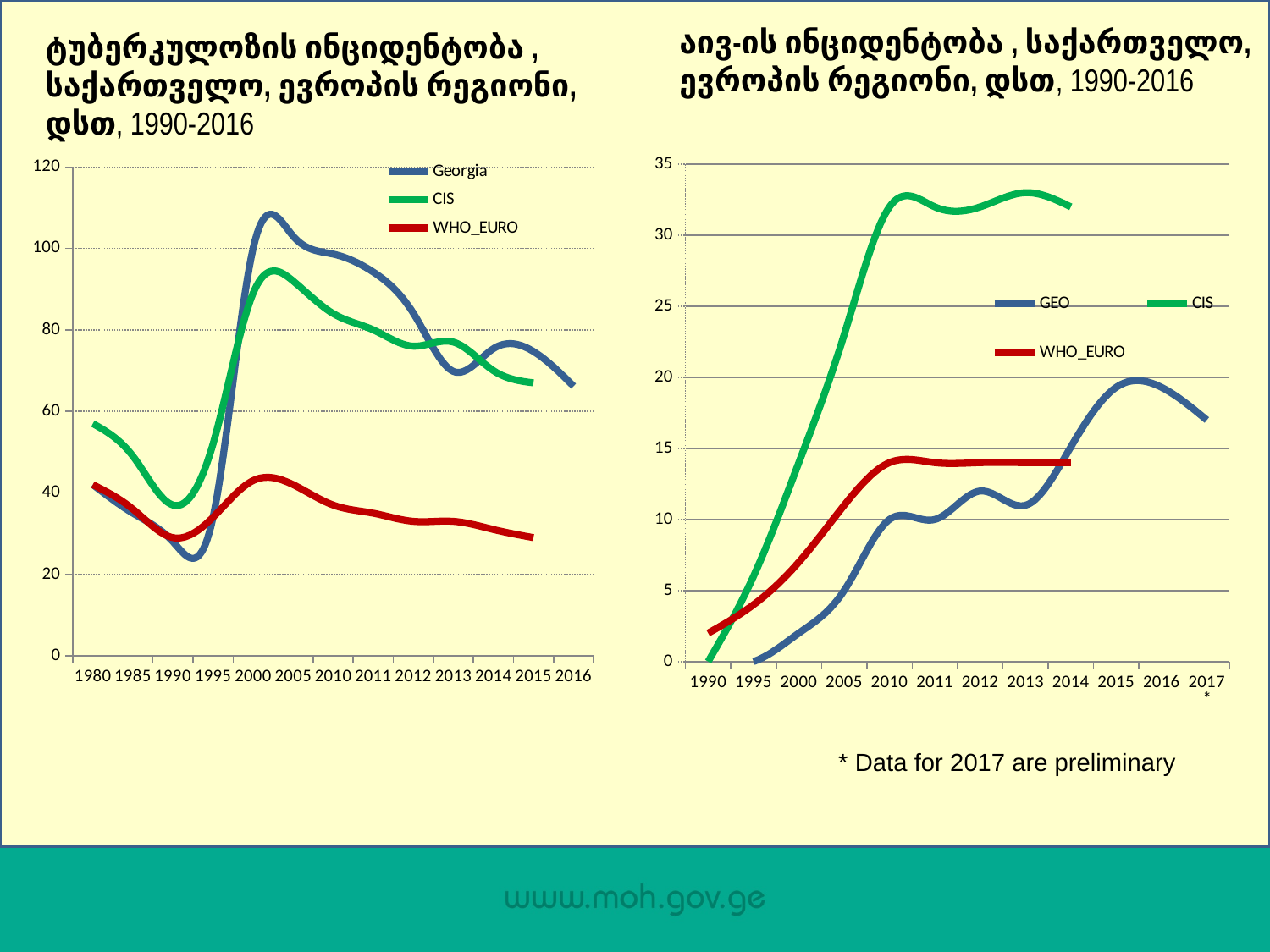
How many series does the legend of the right chart (HIV incidence) list? 3 What kind of chart is the left chart (tuberculosis incidence)? line chart How many years are labelled on the x axis of the left chart (tuberculosis incidence)? 13 In the left chart (tuberculosis incidence), is the value for CIS in 1980 greater or less than 40? greater In the right chart (HIV incidence), is the value for CIS in 2014 greater or less than 30? greater What does the footnote below the right chart (HIV incidence) say about the 2017 data? Data for 2017 are preliminary In the left chart (tuberculosis incidence), does the WHO_EURO line rise or fall from 2005 to 2016? fall How many years are labelled on the x axis of the right chart (HIV incidence)? 12 In the right chart (HIV incidence), which is larger in 2014, CIS or GEO? CIS In the left chart (tuberculosis incidence), is the value for Georgia in 2016 greater or less than 80? less How many series does the legend of the left chart (tuberculosis incidence) list? 3